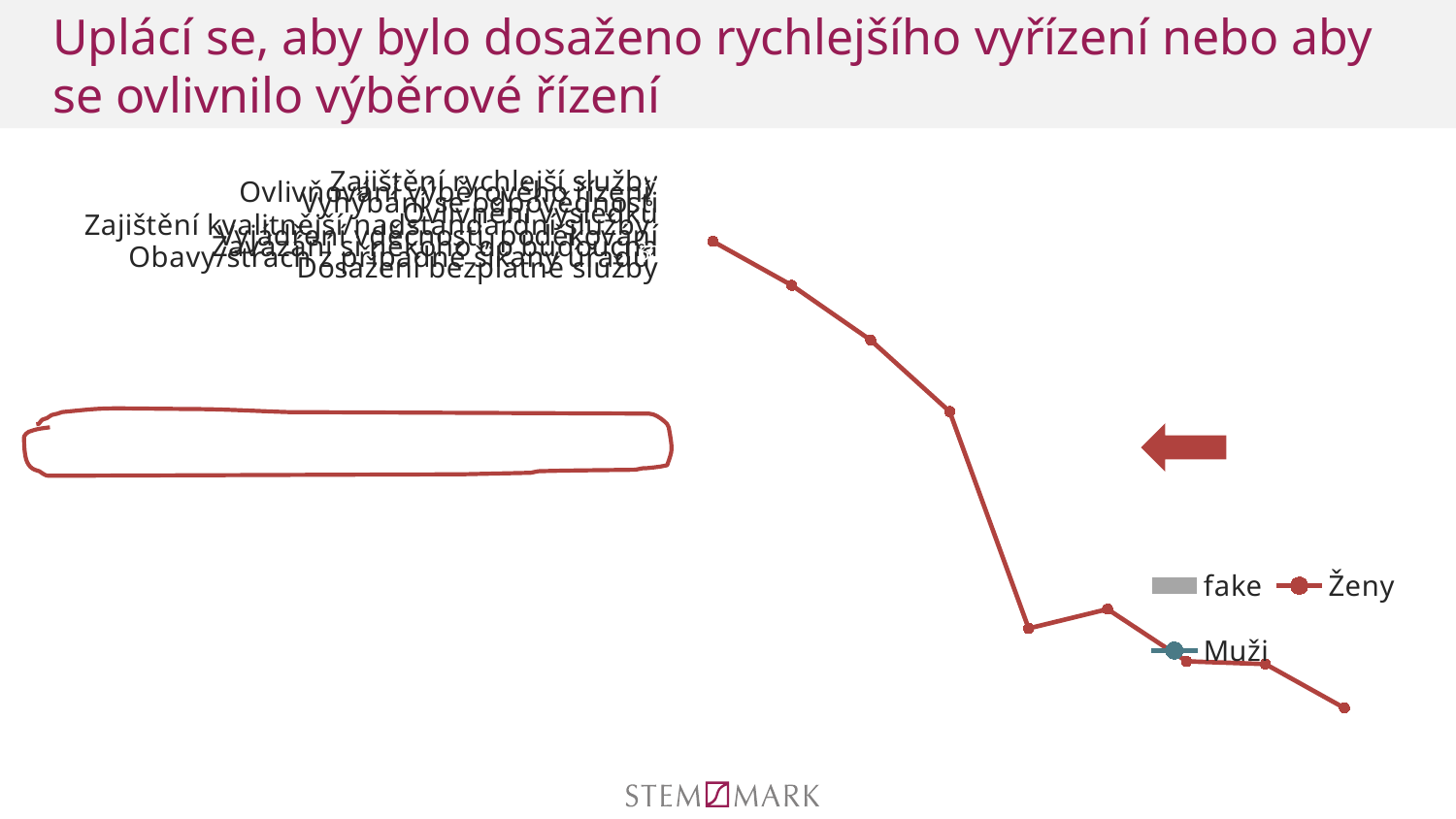
How many data points are plotted on the Ženy line? 9 What kind of chart is shown on the slide? line chart What are the three entries listed in the legend? fake, Ženy, Muži Which series is drawn as a red line with circular markers? Ženy Do the values of the Ženy series rise or fall along the x axis? fall How many series does the legend list? 3